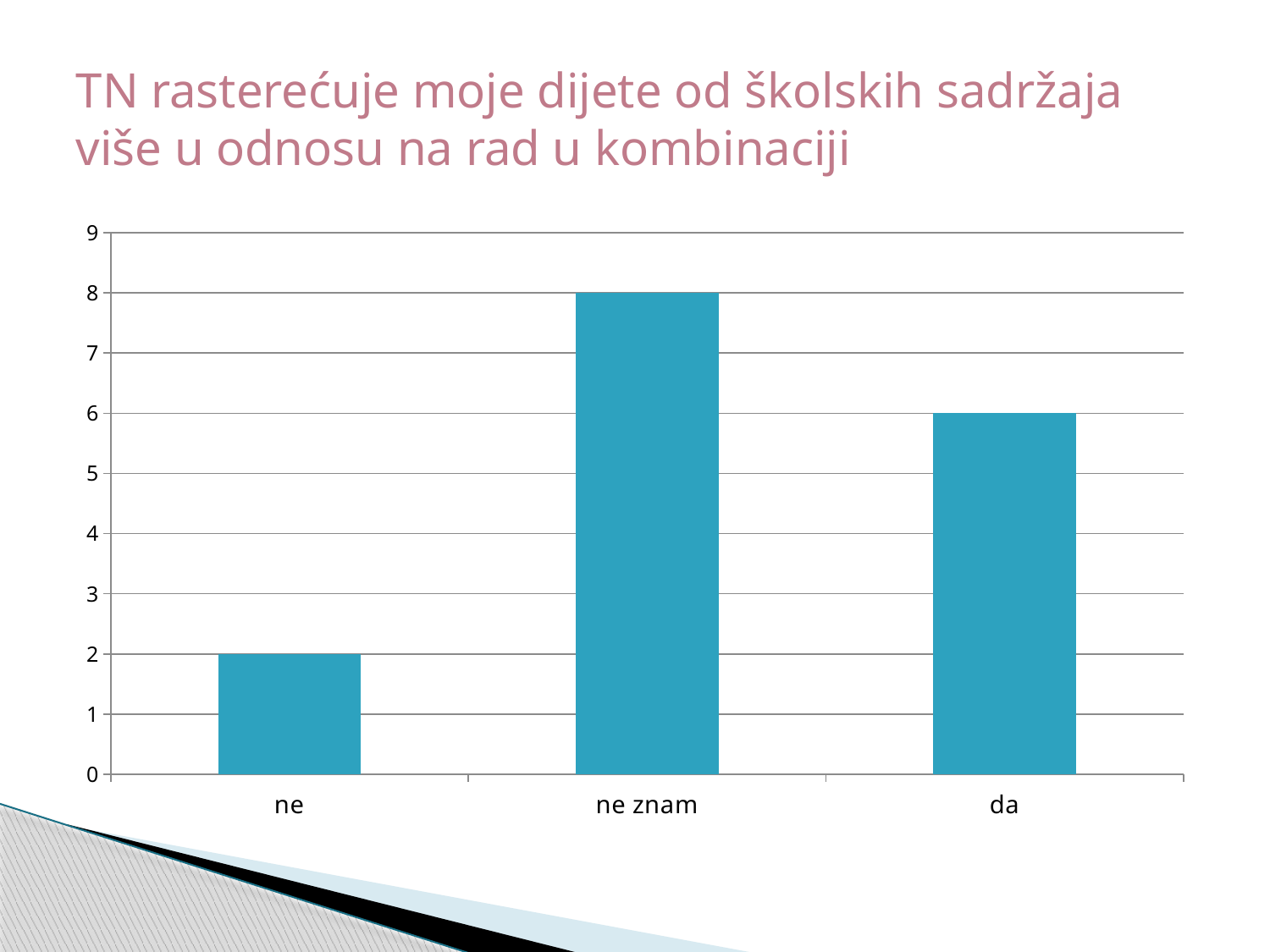
What is the value for "ne znam"? 8 What is the value for "da"? 6 Is the value for "ne znam" greater or less than 5? greater What is the highest value shown on the vertical axis? 9 Which category has the lowest value? ne What is the difference between the values for "ne znam" and "da"? 2 What is the value for "ne"? 2 What kind of chart is shown on the slide? bar chart Which is larger, the value for "da" or the value for "ne"? da How many categories are shown on the x axis? 3 Which category has the highest value? ne znam What is the difference between the values for "da" and "ne"? 4